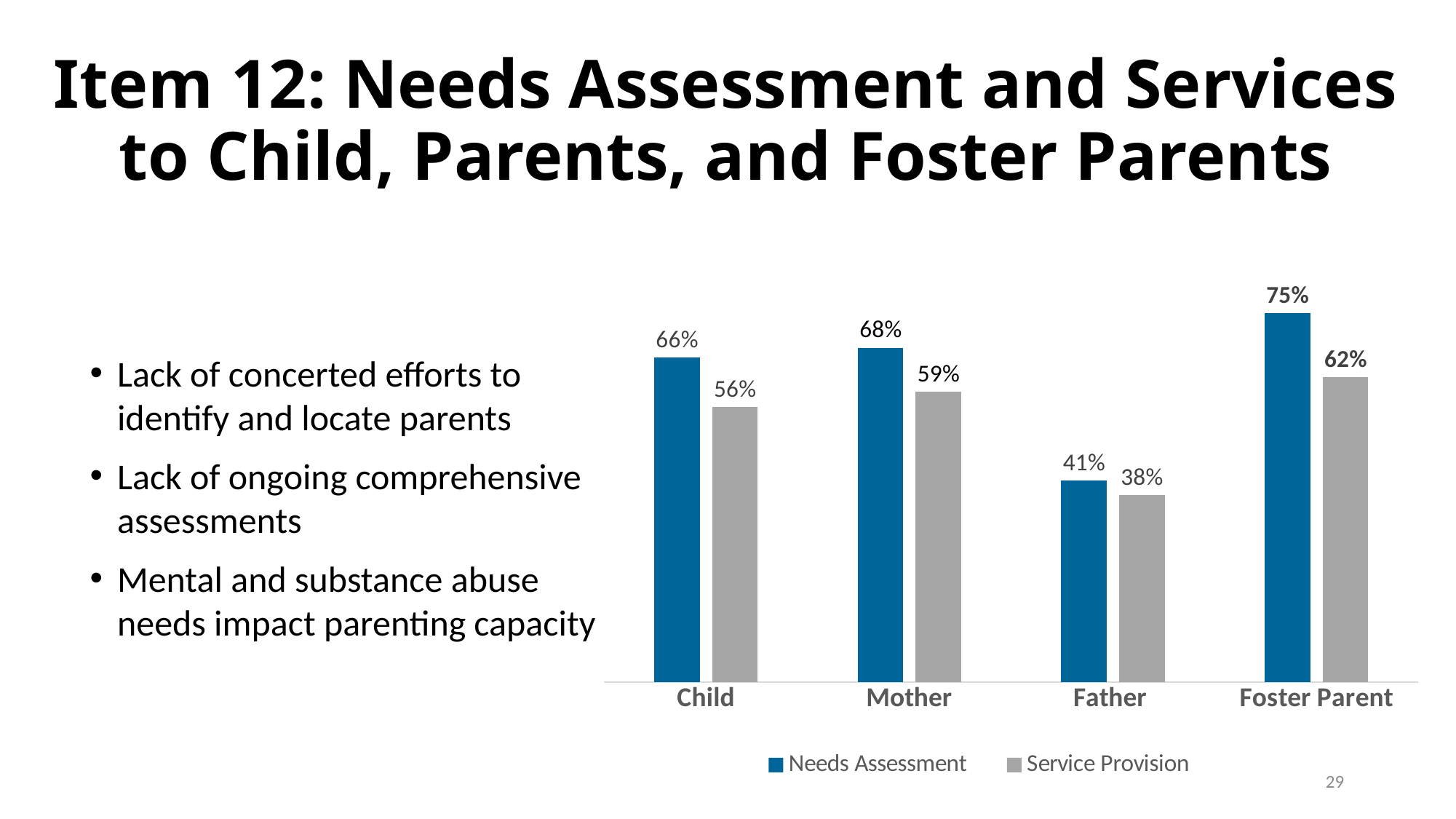
What kind of chart is shown on the slide? Bar chart What is the difference between the Needs Assessment values for Foster Parent and Father? 34% How many series does the legend list? 2 Which category has the lowest Service Provision value? Father What is the Service Provision value for Father? 38% Which series is shown in blue? Needs Assessment What is the difference between the Needs Assessment and Service Provision values for Child? 10% Which category has the highest Needs Assessment value? Foster Parent Which is larger, the Service Provision value for Mother or for Child? Mother What is the Service Provision value for Foster Parent? 62% How many categories are shown on the x axis? 4 What is the Needs Assessment value for Child? 66%